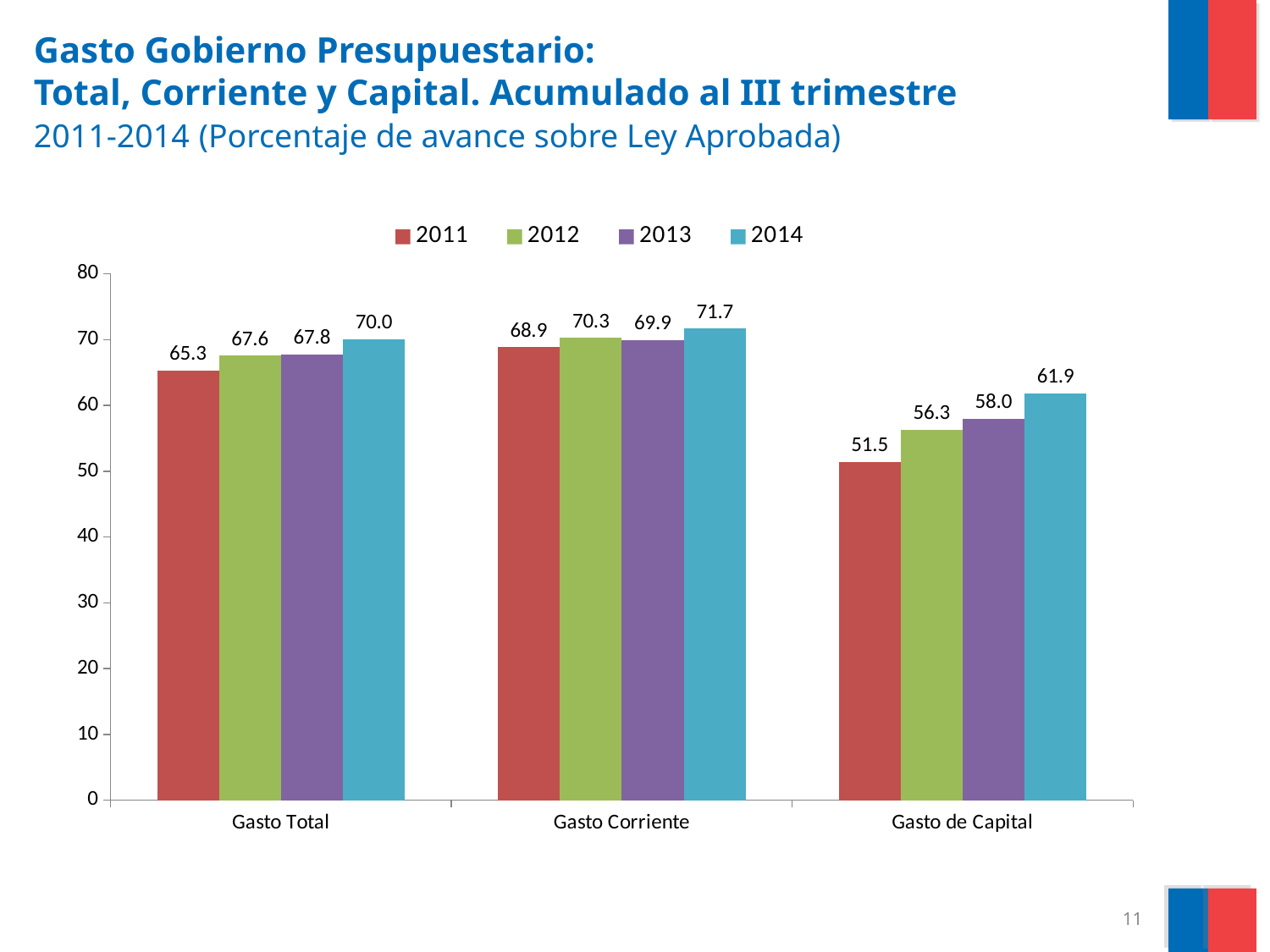
What is the value for Gasto Corriente in 2013? 69.9 Do the values for Gasto de Capital rise or fall from 2011 to 2014? Rise What is the value for Gasto Total in 2014? 70.0 Which category has the lowest value in 2012? Gasto de Capital What is the value for Gasto de Capital in 2011? 51.5 Which category has the highest value in 2014? Gasto Corriente What is the difference between the 2014 and 2011 values for Gasto de Capital? 10.4 Which colour represents the 2014 series in the legend? Light blue How many series does the legend list? 4 What kind of chart is shown on the slide? Bar chart How many categories are shown on the x axis? 3 Which is larger: Gasto Total in 2012 or Gasto de Capital in 2014? Gasto Total in 2012